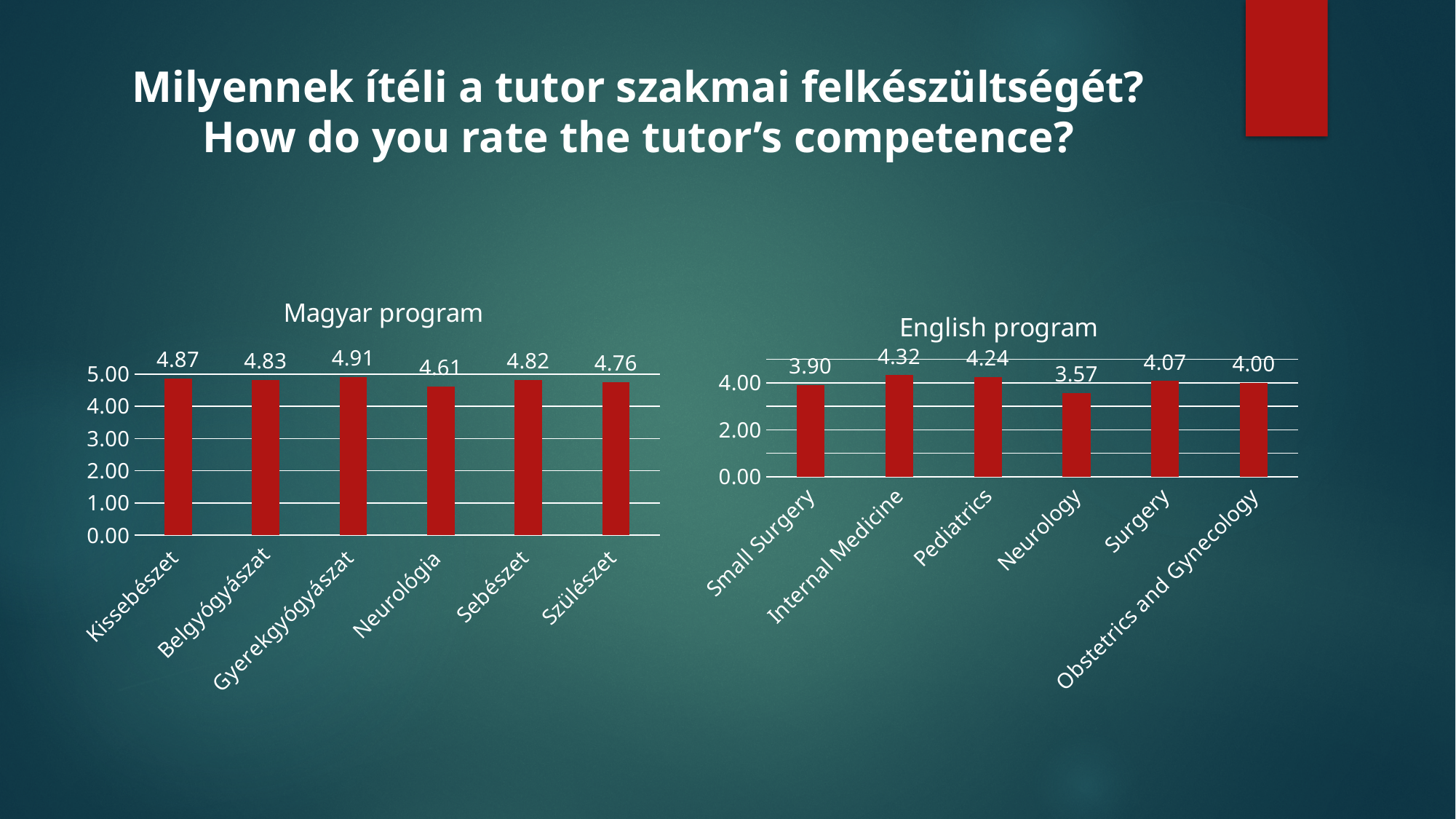
In the Magyar program chart, which category has the lowest value? Neurológia What kind of chart is the Magyar program chart? bar chart In the Magyar program chart, is the value for Neurológia greater or less than 4.00? greater In the Magyar program chart, what is the value for Gyerekgyógyászat? 4.91 In the English program chart, what is the value for Internal Medicine? 4.32 In the English program chart, what is the difference between Internal Medicine and Neurology? 0.75 In the Magyar program chart, what is the value for Szülészet? 4.76 In the English program chart, which category has the lowest value? Neurology In the Magyar program chart, what is the difference between Gyerekgyógyászat and Neurológia? 0.30 In the English program chart, which is larger, Pediatrics or Surgery? Pediatrics In the English program chart, which category has the highest value? Internal Medicine How many categories does the English program chart show? 6